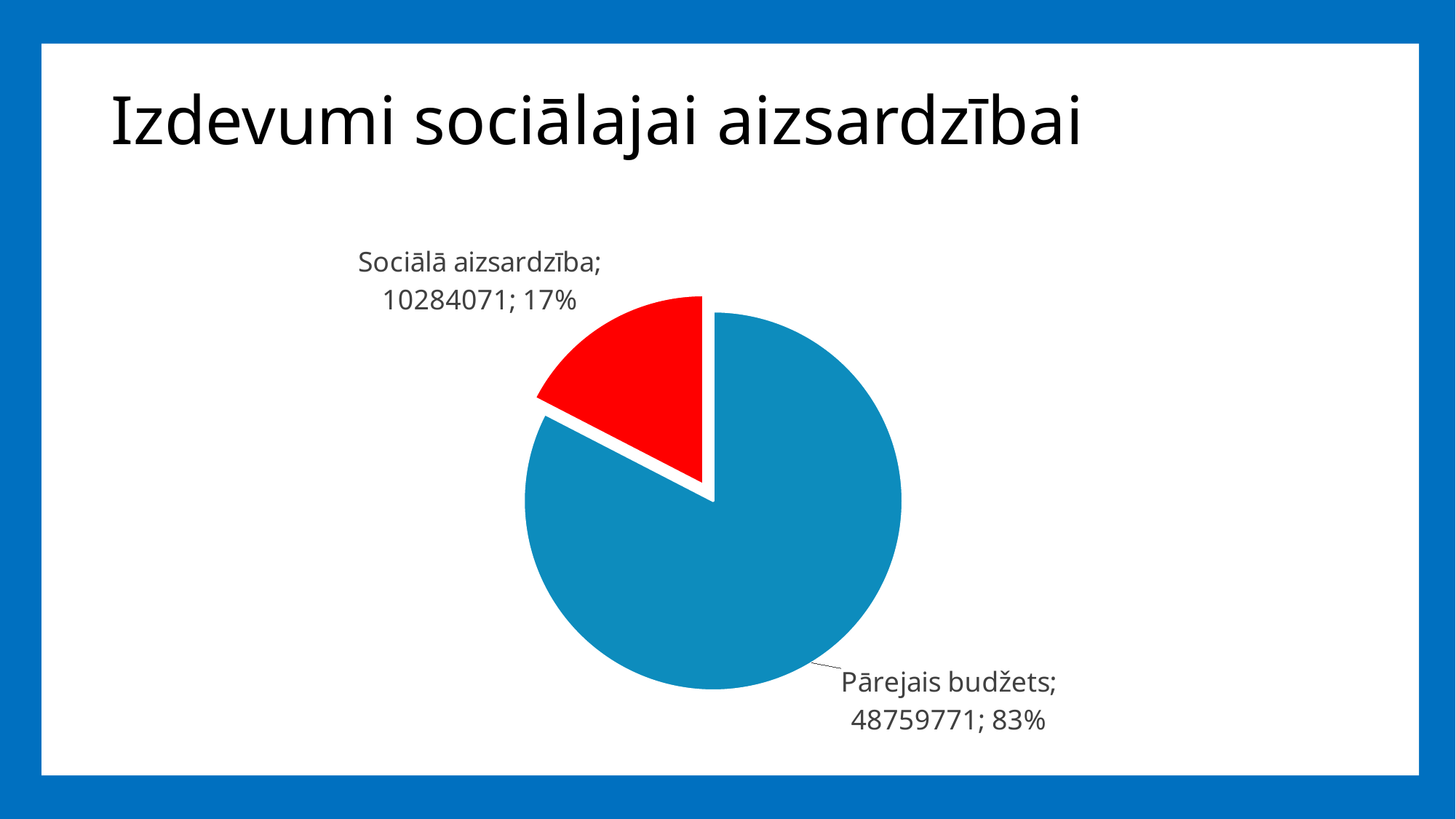
Which slice is the smallest? Sociālā aizsardzība Which slice is the largest? Pārejais budžets What is the difference between the values for Pārejais budžets and Sociālā aizsardzība? 38475700 What kind of chart is shown on the slide? pie chart What share of the pie does Pārejais budžets represent? 83% What is the total of the two slices? 59043842 How many slices does the pie chart have? 2 Which is larger, Sociālā aizsardzība or Pārejais budžets? Pārejais budžets What is the value for Sociālā aizsardzība? 10284071 What colour is the Sociālā aizsardzība slice? red What is the value for Pārejais budžets? 48759771 What share of the pie does Sociālā aizsardzība represent? 17%